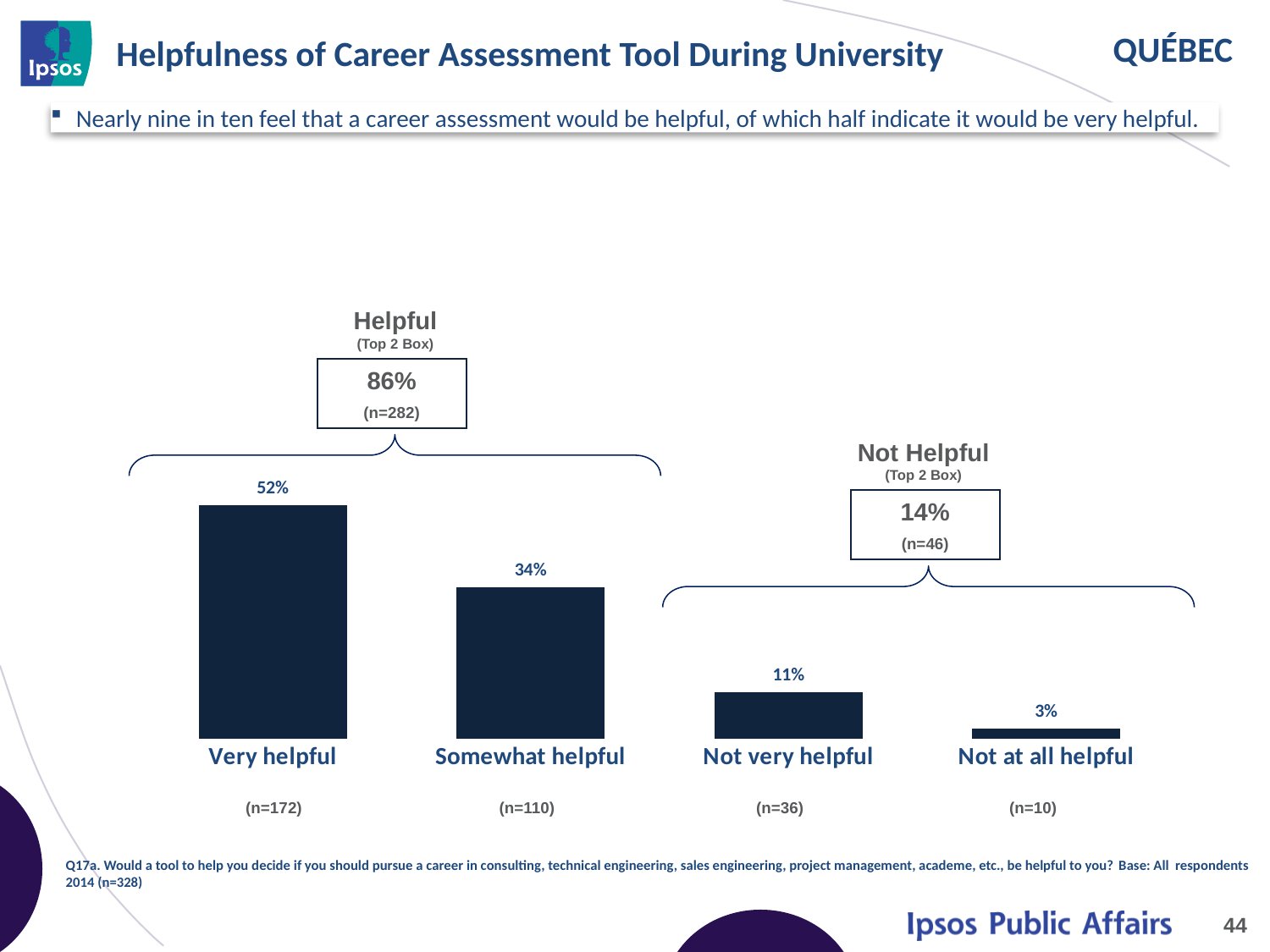
Which category has the highest percentage? Very helpful What percentage of respondents said a career assessment tool would be not at all helpful? 3% What is the Helpful (Top 2 Box) percentage shown above the chart? 86% What is the difference in percentage points between Very helpful and Somewhat helpful? 18 Which is larger, the percentage for Somewhat helpful or for Not very helpful? Somewhat helpful What percentage of respondents said a career assessment tool would be not very helpful? 11% What percentage of respondents said a career assessment tool would be very helpful? 52% What percentage of respondents said a career assessment tool would be somewhat helpful? 34% What kind of chart is shown on the slide? Bar chart What is the sample size (n) for the Not very helpful category? n=36 How many categories are shown in the chart? 4 Which category has the lowest percentage? Not at all helpful